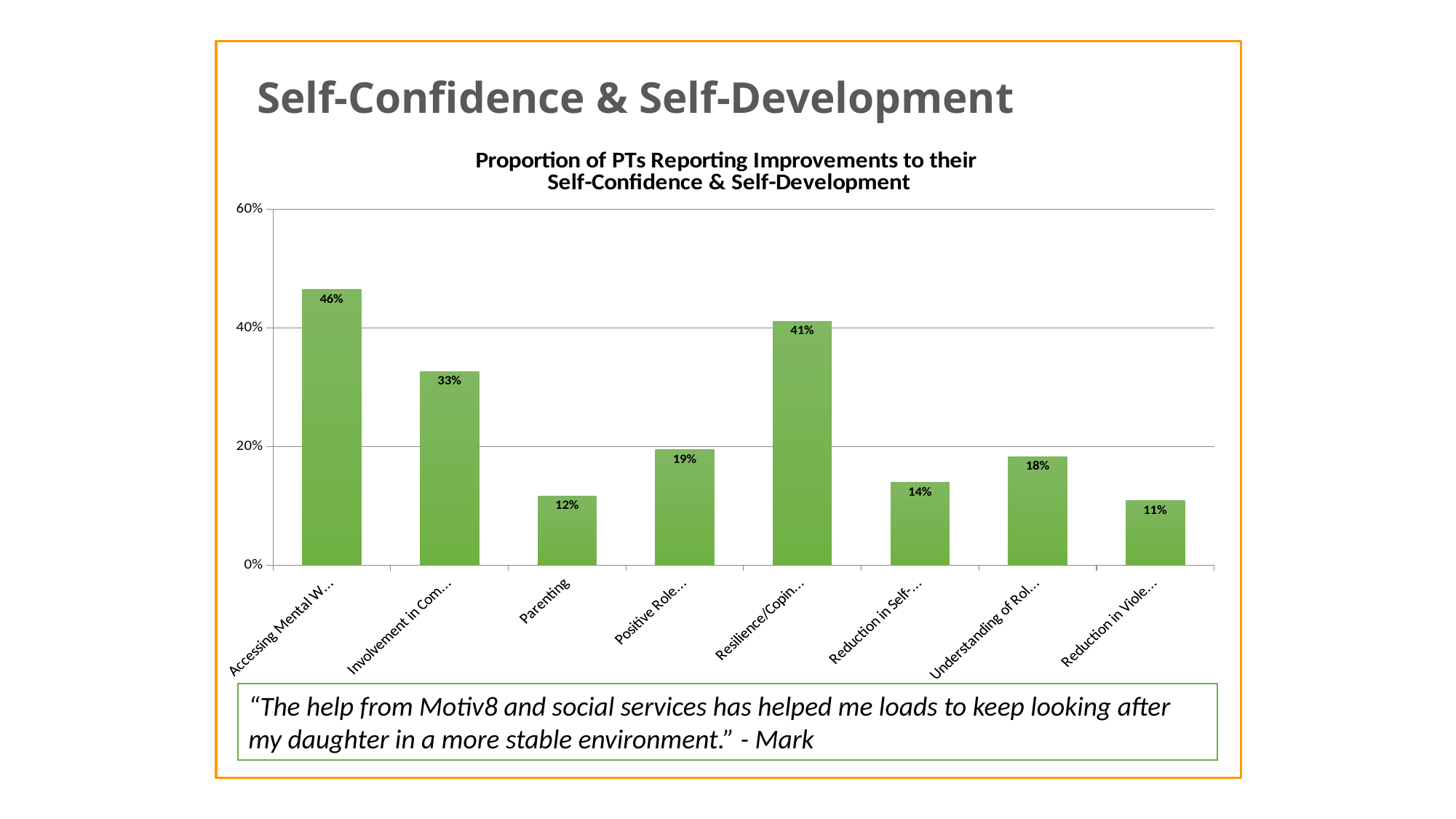
What is the value of the last (rightmost) bar, labelled 'Reduction in Viole...'? 11% What is the value for Parenting? 12% Which bar has the lowest value? Reduction in Viole... (11%) What is the difference between the first bar (46%) and the second bar labelled 'Involvement in Com...' (33%)? 13% Which is larger: the value for Parenting or the value for the bar labelled 'Positive Role...'? Positive Role... (19%) What type of chart is shown on the slide? bar chart Is the value for the bar labelled 'Understanding of Rol...' greater or less than 20%? less What is the title of the chart? Proportion of PTs Reporting Improvements to their Self-Confidence & Self-Development What is the value of the bar labelled 'Resilience/Copin...'? 41% How many bars are plotted in the chart? 8 What is the value of the first (leftmost) bar, labelled 'Accessing Mental W...'? 46% Which bar has the highest value? Accessing Mental W... (46%)